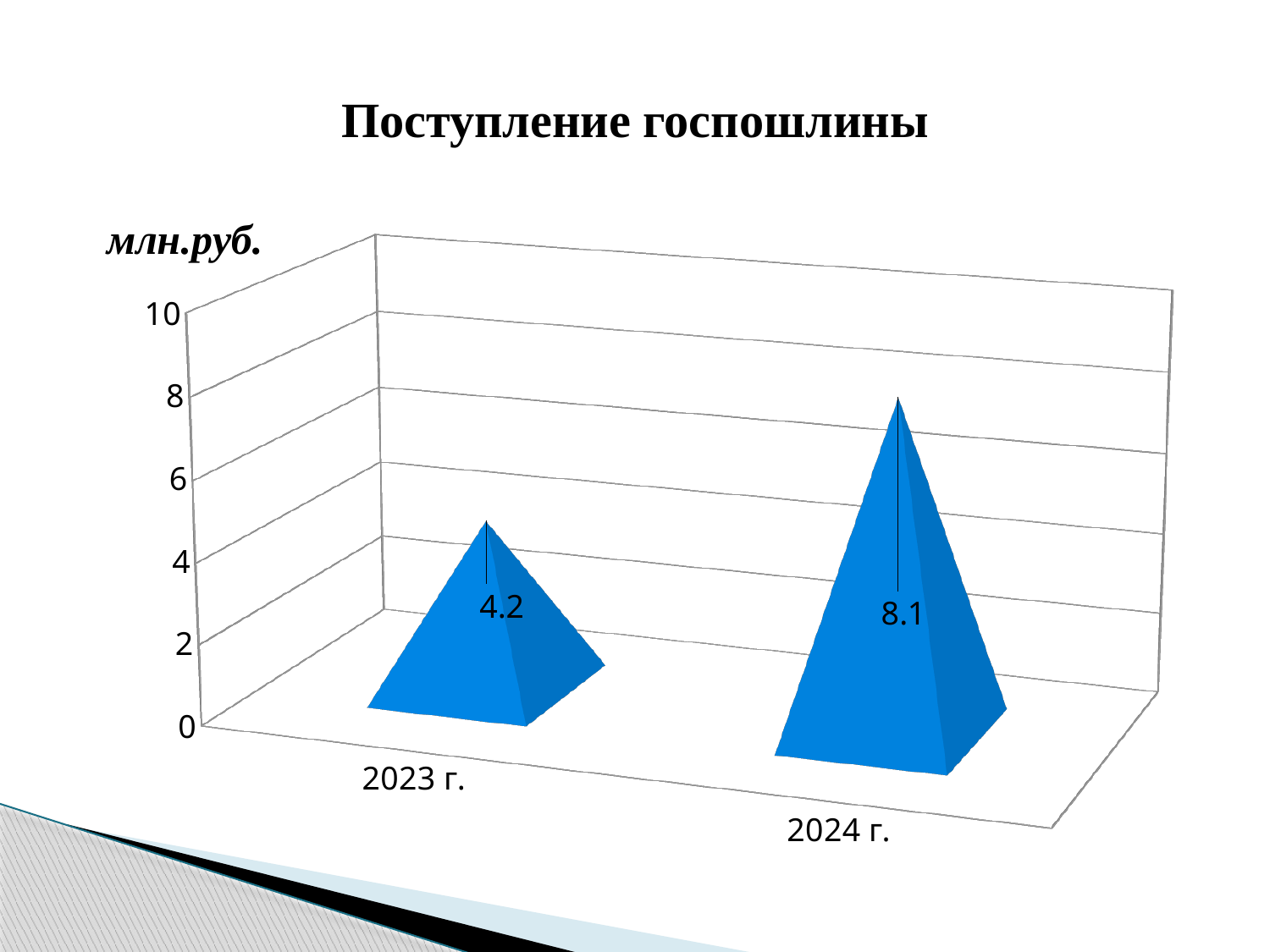
Which year has the lowest value? 2023 г. What is the value for 2024 г.? 8.1 What is the title of the chart? Поступление госпошлины What is the difference between the values for 2024 г. and 2023 г.? 3.9 Is the value for 2024 г. greater or less than 6? greater Do the values rise or fall from 2023 г. to 2024 г.? rise Which year has the highest value? 2024 г. How many categories are shown on the chart? 2 Is the value for 2023 г. greater or less than 6? less Which is larger, the value for 2023 г. or the value for 2024 г.? 2024 г. What kind of chart is shown on the slide? bar chart What is the value for 2023 г.? 4.2